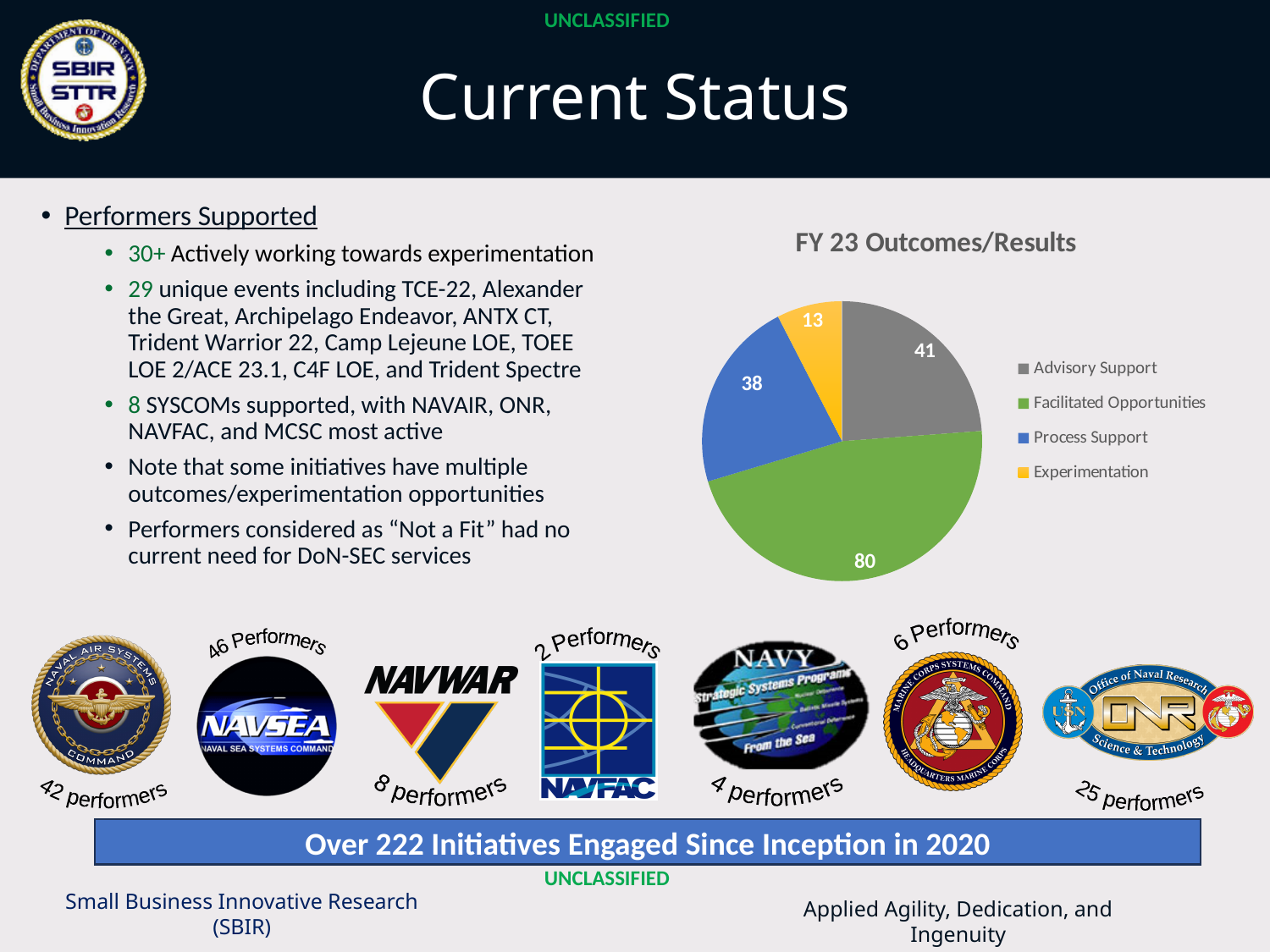
Which category has the smallest slice in the FY 23 Outcomes/Results pie chart? Experimentation What type of chart is shown under the title "FY 23 Outcomes/Results"? pie chart What colour is the Experimentation slice in the FY 23 Outcomes/Results pie chart? yellow How many categories does the legend of the FY 23 Outcomes/Results pie chart list? 4 What is the value for Facilitated Opportunities in the FY 23 Outcomes/Results pie chart? 80 What is the value for Advisory Support in the FY 23 Outcomes/Results pie chart? 41 In the FY 23 Outcomes/Results pie chart, what is the difference between the Facilitated Opportunities value and the Advisory Support value? 39 What is the value for Process Support in the FY 23 Outcomes/Results pie chart? 38 What is the value for Experimentation in the FY 23 Outcomes/Results pie chart? 13 In the FY 23 Outcomes/Results pie chart, which is larger: Advisory Support or Process Support? Advisory Support Which category has the largest slice in the FY 23 Outcomes/Results pie chart? Facilitated Opportunities What is the title of the chart on the slide? FY 23 Outcomes/Results